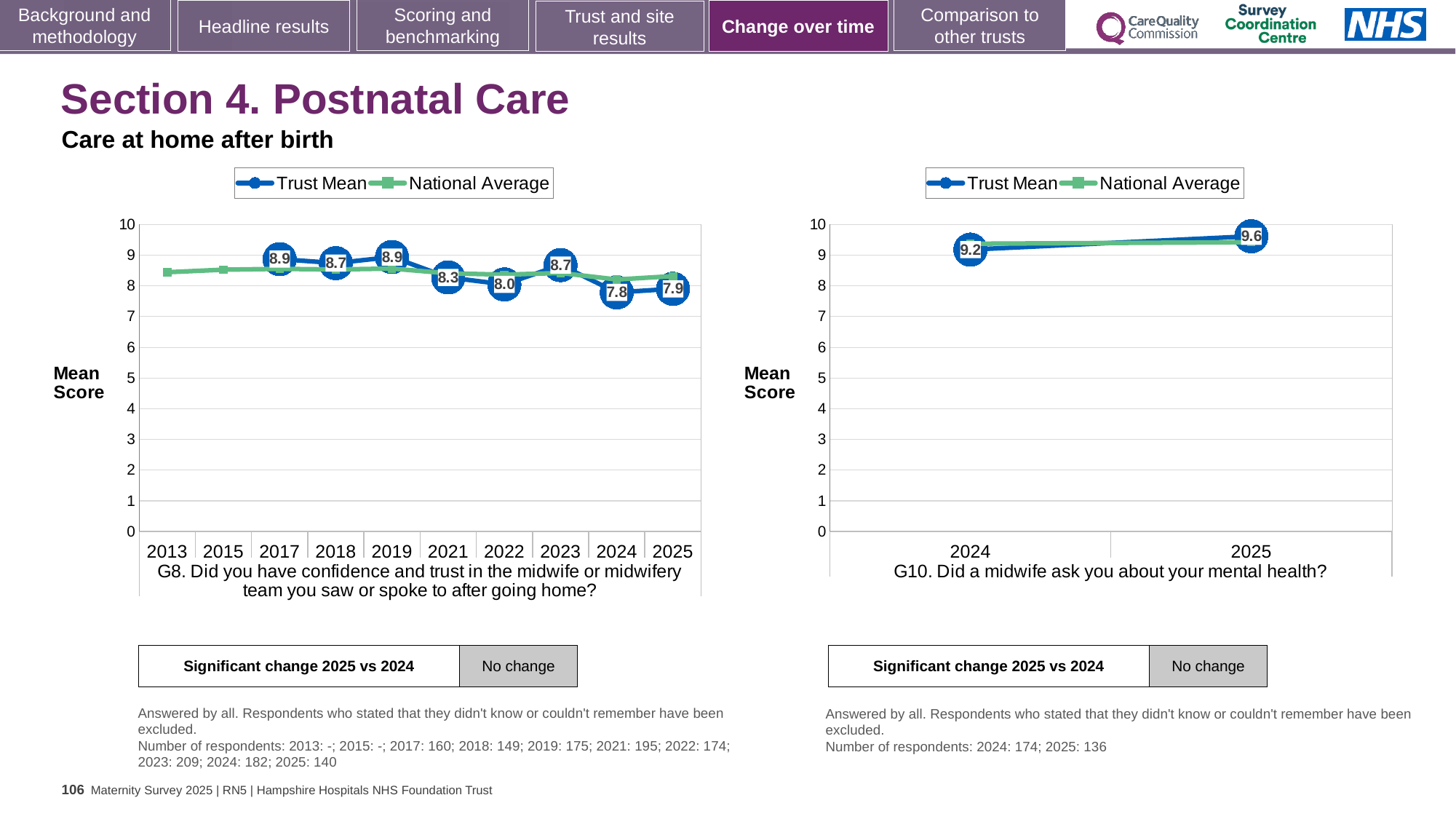
In the G8 chart, what is the Trust Mean score for 2022? 8.0 In the G8 chart, what is the Trust Mean score for 2024? 7.8 In the G8 chart, which year has the lowest Trust Mean score? 2024 In the G10 chart, what is the Trust Mean score for 2025? 9.6 What type of chart is used for G8? Line chart In the G10 chart, what is the Trust Mean score for 2024? 9.2 How many years are shown on the x axis of the G10 chart? 2 In the G8 chart, is the National Average for 2013 greater or less than 9? less In the G8 chart, is the Trust Mean score for 2023 larger than the score for 2021? Yes, 2023 (8.7) How many series does the legend of the G8 chart list? 2 In the G10 chart, by how much did the Trust Mean score change from 2024 to 2025? 0.4 In the G8 chart, what is the difference between the Trust Mean scores for 2019 and 2025? 1.0